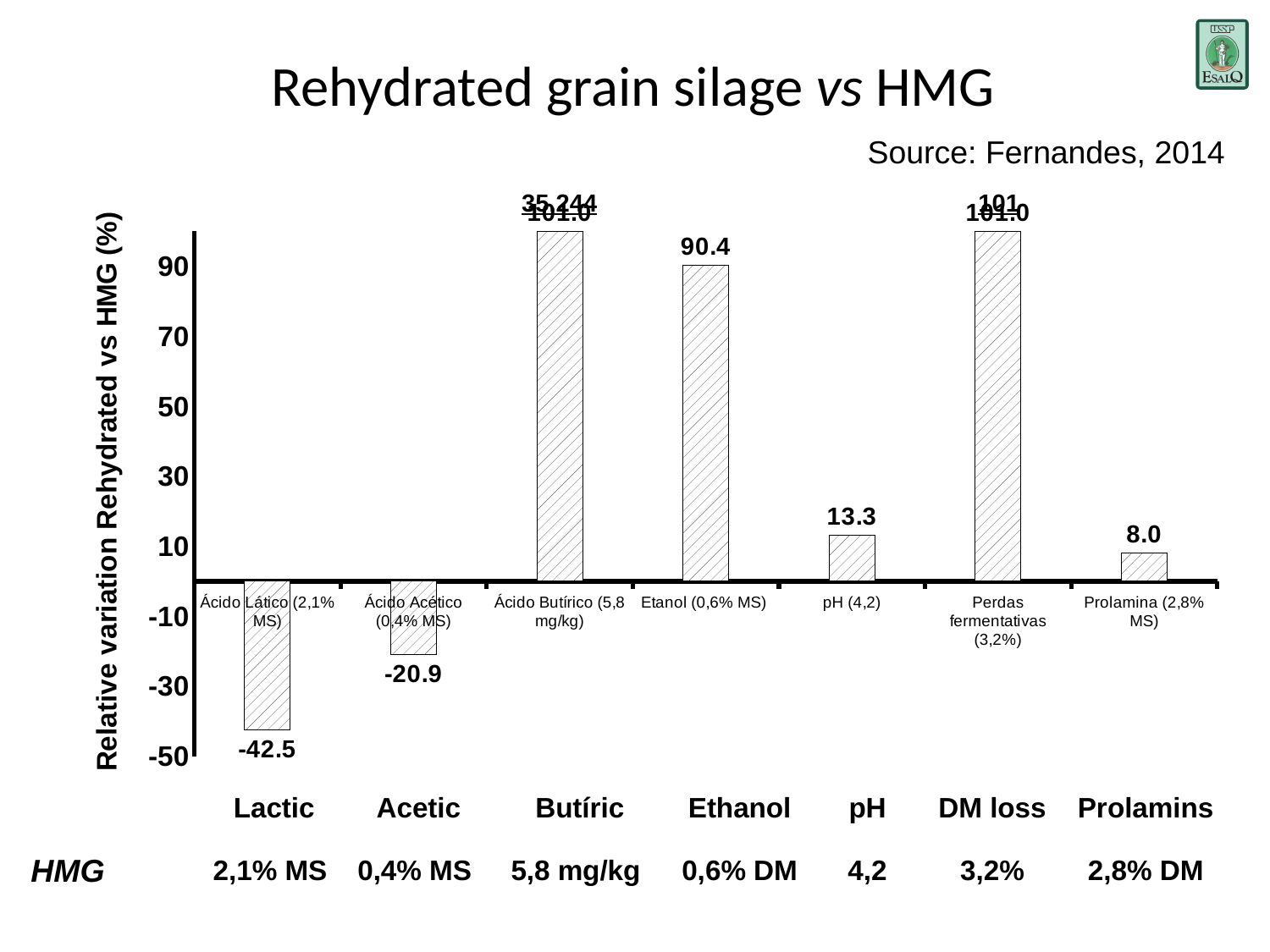
What kind of chart is shown on the slide? Bar chart Is the value for Etanol greater or less than 70? greater What is the relative variation value for Ácido Lático (Lactic)? -42.5 What is the relative variation value for Etanol (Ethanol)? 90.4 What is the relative variation value for Prolamina (Prolamins)? 8.0 What is the difference between the values for Etanol and pH? 77.1 Which is larger, the value for Etanol or the value for pH? Etanol What is the relative variation value for pH? 13.3 How many categories are plotted on the chart? 7 Which category has the lowest relative variation value? Ácido Lático (Lactic) What is the title of the vertical axis? Relative variation Rehydrated vs HMG (%) What is the relative variation value for Ácido Acético (Acetic)? -20.9